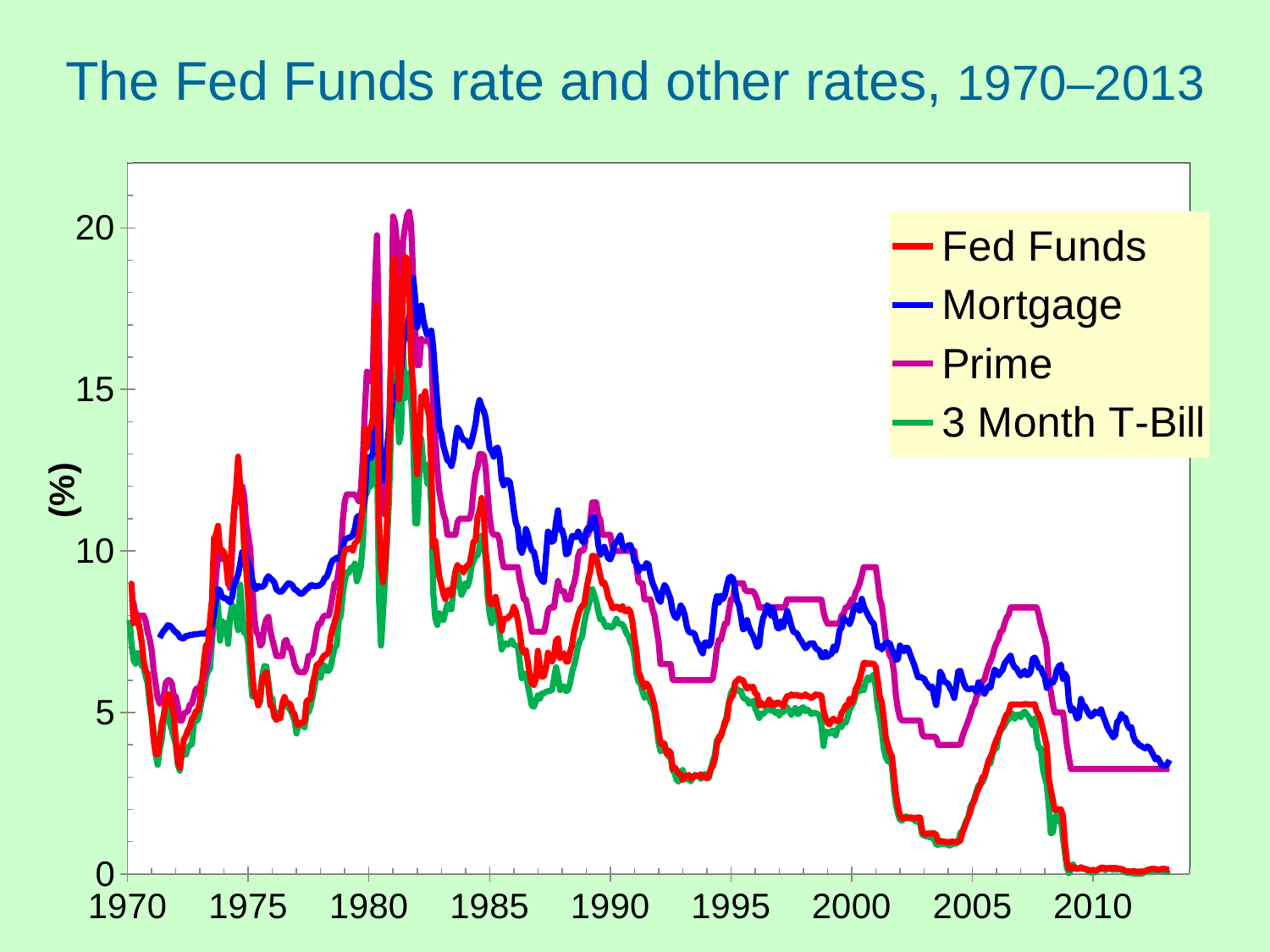
What label is shown on the vertical axis? (%) Is the Prime rate in 2007 greater or less than 5? greater Is the Fed Funds rate in 1993 greater or less than 5? less What is the title of the chart? The Fed Funds rate and other rates, 1970–2013 Does the Mortgage rate rise or fall from 2007 to 2013? Fall What kind of chart is shown on the slide? Line chart Which series reaches the highest value on the chart? Prime In 1995, which is higher, the Mortgage rate or the 3 Month T-Bill rate? Mortgage Is the Fed Funds rate in 2012 greater or less than 1? less How many series does the legend list? 4 In 2007, which is higher, the Prime rate or the Fed Funds rate? Prime